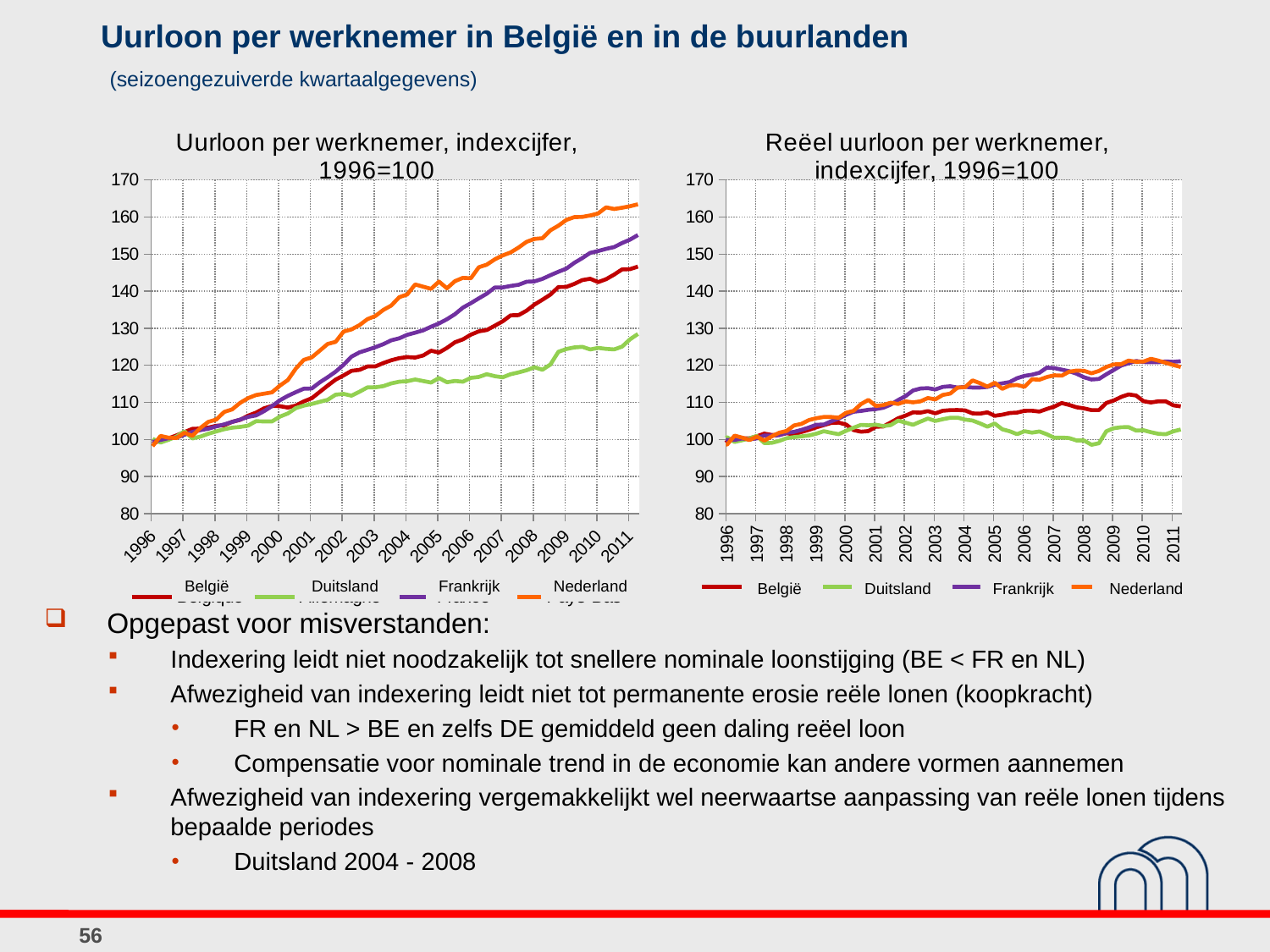
What kind of chart is the left chart, 'Uurloon per werknemer, indexcijfer, 1996=100'? line chart How many series does the legend of the right chart, 'Reëel uurloon per werknemer, indexcijfer, 1996=100', list? 4 In the left chart, 'Uurloon per werknemer, indexcijfer, 1996=100', which country has the highest value in 2011? Nederland In the left chart, 'Uurloon per werknemer, indexcijfer, 1996=100', is the value for Duitsland in 2011 greater or less than 140? less In the right chart, 'Reëel uurloon per werknemer, indexcijfer, 1996=100', is the value for Duitsland in 2011 greater or less than 110? less Which country is shown in orange in the legend of the right chart, 'Reëel uurloon per werknemer, indexcijfer, 1996=100'? Nederland In the left chart, 'Uurloon per werknemer, indexcijfer, 1996=100', which is larger in 2011: the value for Frankrijk or the value for België? Frankrijk In the left chart, 'Uurloon per werknemer, indexcijfer, 1996=100', does the value for Nederland rise or fall from 1996 to 2011? rise In the left chart, 'Uurloon per werknemer, indexcijfer, 1996=100', which country has the lowest value in 2011? Duitsland In the right chart, 'Reëel uurloon per werknemer, indexcijfer, 1996=100', is the value for Nederland in 2011 greater or less than 110? greater In the right chart, 'Reëel uurloon per werknemer, indexcijfer, 1996=100', which country has the lowest value in 2011? Duitsland